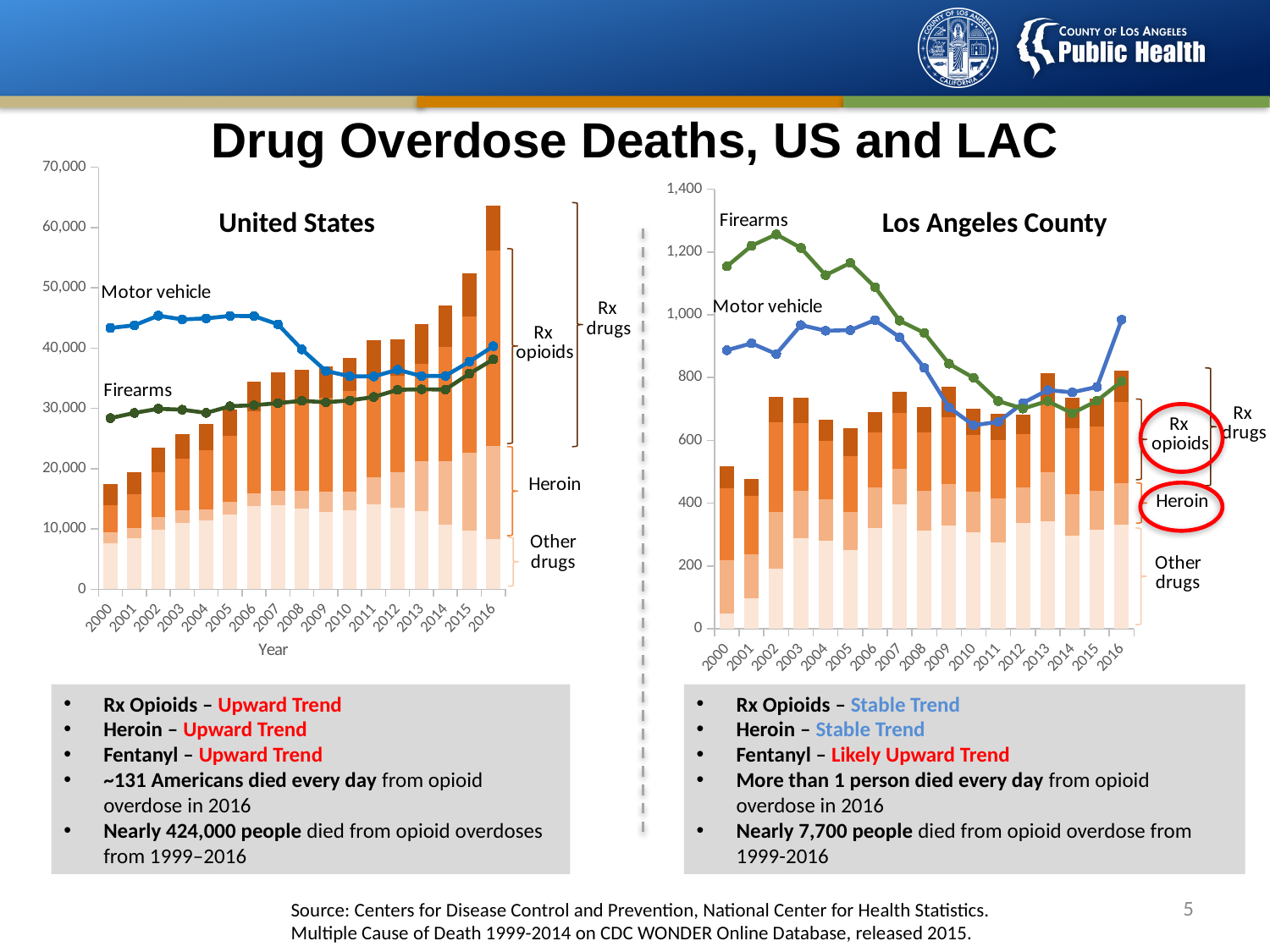
On the United States chart, how many years are shown along the x axis? 17 On the United States chart, is the Motor vehicle value for 2000 greater or less than 40,000? greater On the United States chart, does the Firearms line generally rise or fall from 2000 to 2016? rise On the Los Angeles County chart, in 2016, which is higher: the Motor vehicle line or the Firearms line? Motor vehicle On the United States chart, which year has the lowest total stacked bar? 2000 On the United States chart, is the total height of the stacked bar for 2016 greater or less than 60,000? greater On the Los Angeles County chart, is the Firearms value for 2002 greater or less than 1,200? greater On the Los Angeles County chart, which two bar segment labels are circled in red? Rx opioids and Heroin On the United States chart, what kind of chart is used to show the drug overdose deaths by drug type? a stacked bar chart (with line series overlaid) On the United States chart, what is the title of the x axis? Year On the Los Angeles County chart, in which year does the Firearms line reach its highest value? 2002